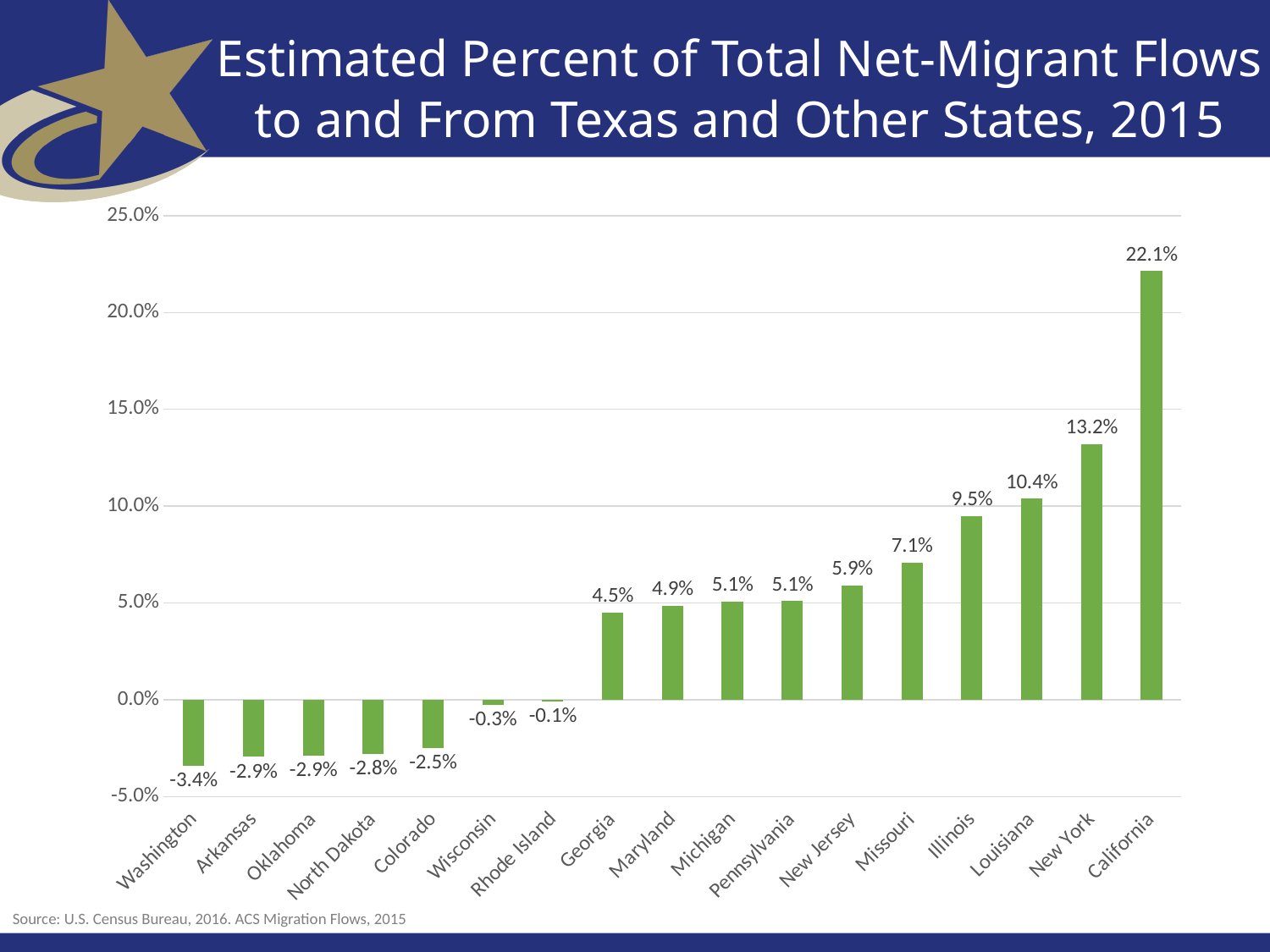
Do the values rise or fall from left to right along the x axis? Rise What is the difference between the values for California and New York? 8.9% Which state has the highest value? California Which state has the lowest value? Washington Is the value for New York greater or less than 10.0%? greater What kind of chart is this? Bar chart What is the value for Washington? -3.4% What is the value for Missouri? 7.1% How many states are shown on the chart? 17 Which is larger, the value for Illinois or the value for Louisiana? Louisiana What is the title of the chart? Estimated Percent of Total Net-Migrant Flows to and From Texas and Other States, 2015 What is the value for California? 22.1%